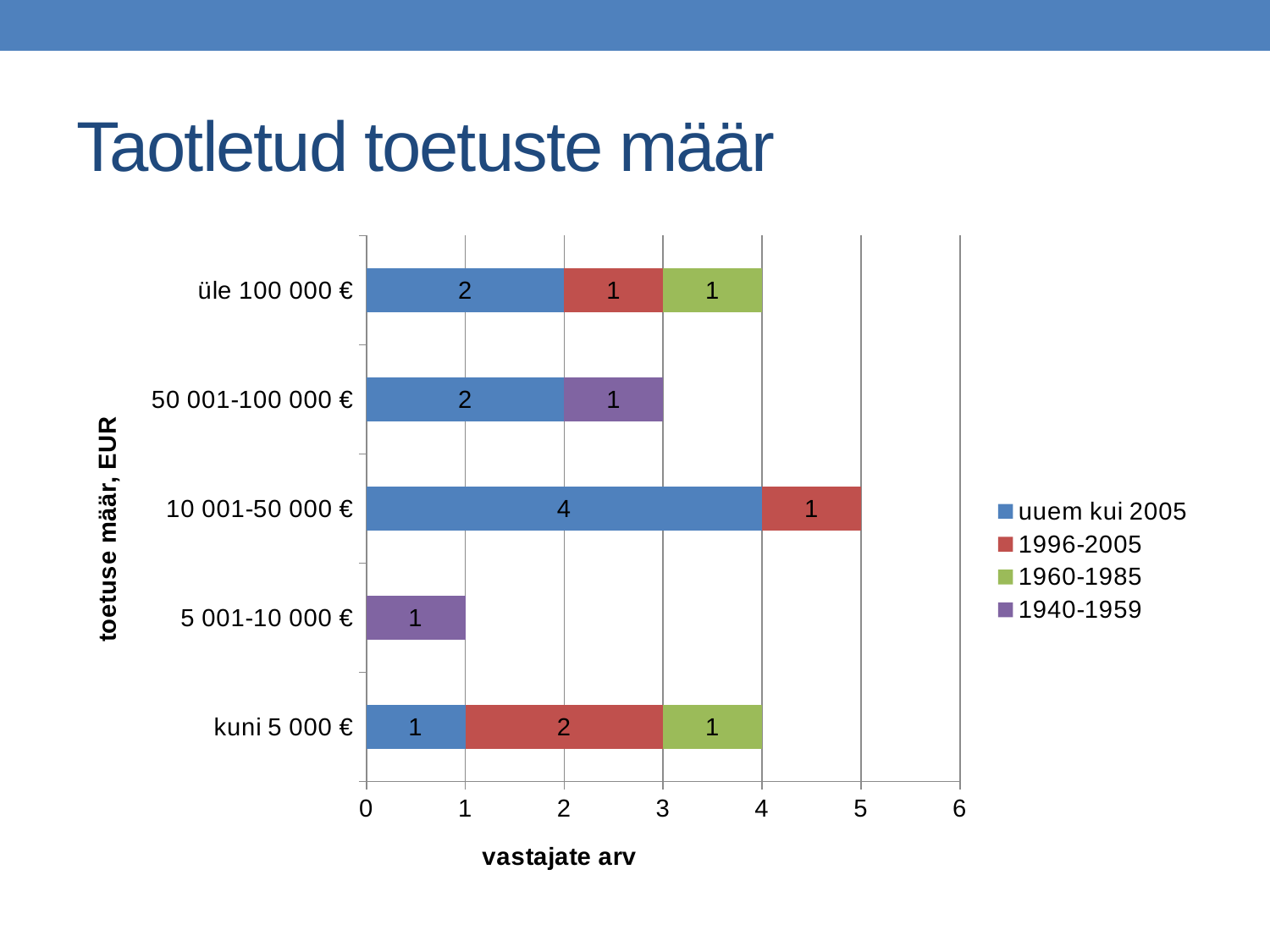
What is the total of the stacked bar for '10 001-50 000 €'? 5 What is the value for '1996-2005' in the 'kuni 5 000 €' category? 2 What is the value for '1940-1959' in the '50 001-100 000 €' category? 1 What is the total of the stacked bar for 'üle 100 000 €'? 4 What is the title of the x axis? vastajate arv What kind of chart is shown on the slide? bar chart How many categories are shown on the vertical axis? 5 What is the difference between the 'uuem kui 2005' values for '10 001-50 000 €' and 'kuni 5 000 €'? 3 What is the value for 'uuem kui 2005' in the '10 001-50 000 €' category? 4 Which category has the lowest total number of respondents? 5 001-10 000 € Which category has the highest total number of respondents? 10 001-50 000 € How many series does the legend list? 4